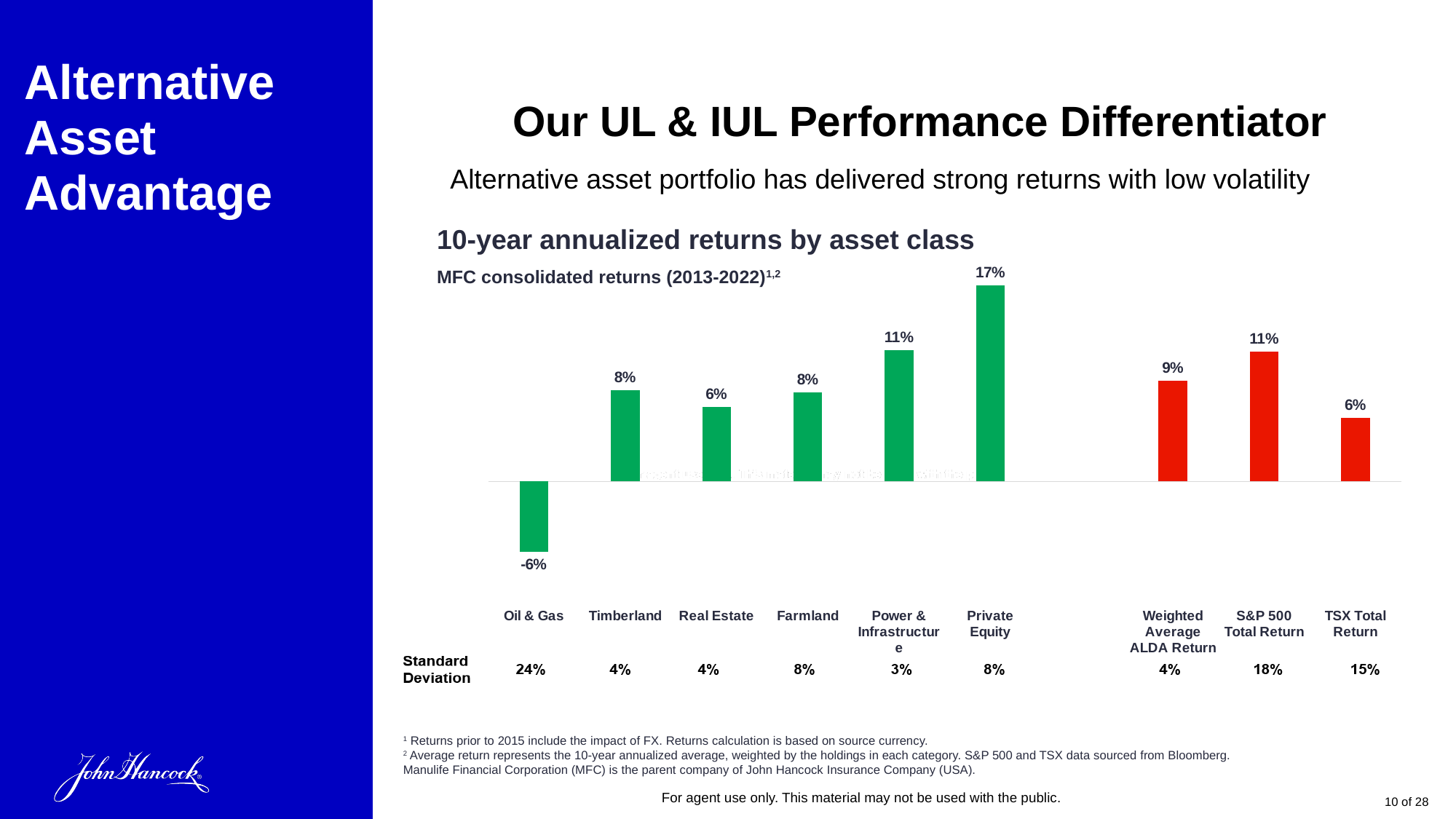
Which category has the lowest 10-year annualized return? Oil & Gas What is the 10-year annualized return for Private Equity? 17% What is the difference between the Private Equity return and the S&P 500 Total Return? 6% What is the 10-year annualized return for the Weighted Average ALDA Return? 9% What kind of chart is used to show the 10-year annualized returns by asset class? Bar chart What is the 10-year annualized return for Oil & Gas? -6% Which is larger, the return for Timberland or the return for Real Estate? Timberland Which asset class has the highest 10-year annualized return? Private Equity How many categories are shown in the bar chart? 9 What is the standard deviation shown for Oil & Gas? 24% What is the title of the chart? 10-year annualized returns by asset class What is the standard deviation shown for Power & Infrastructure? 3%